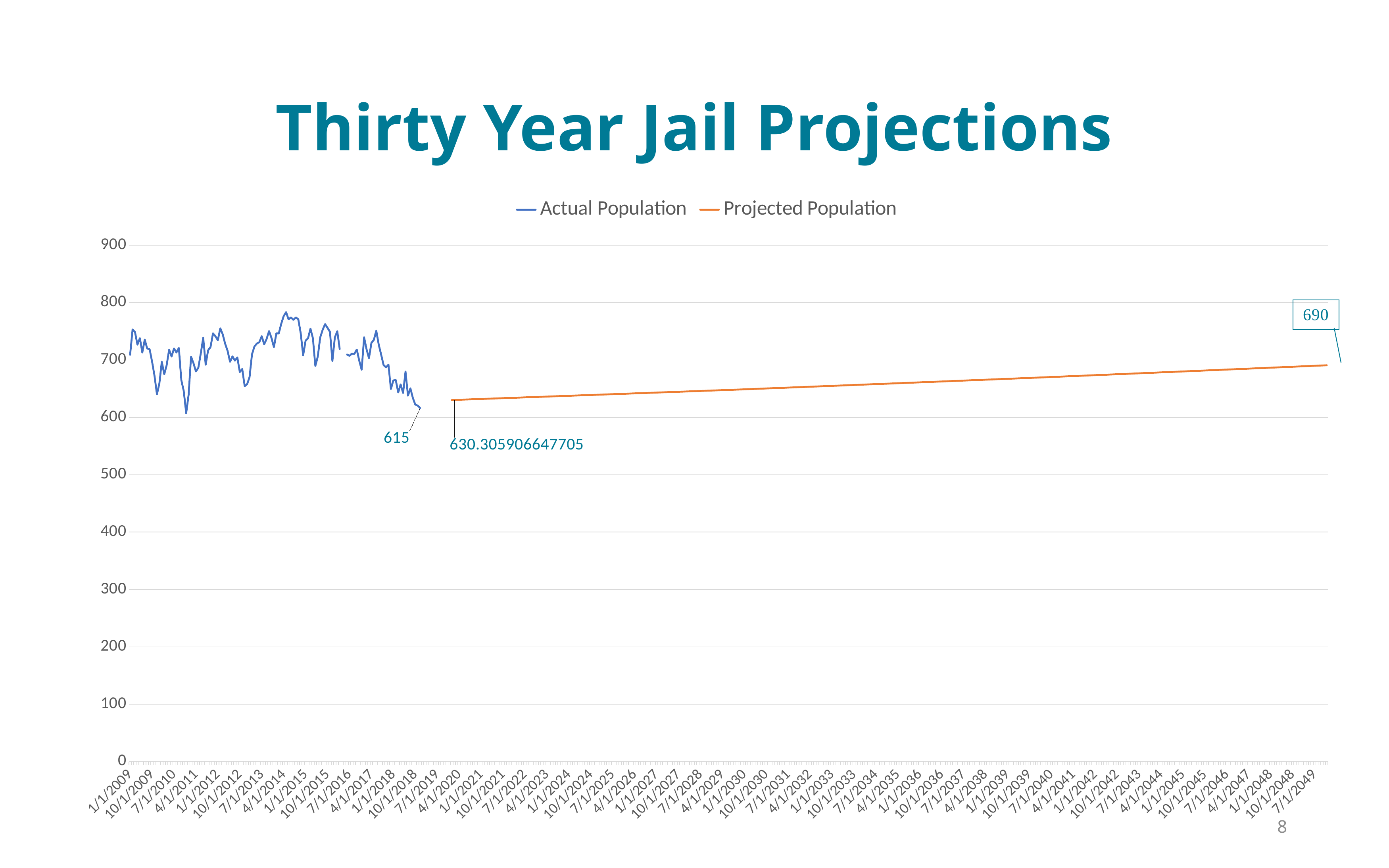
Does the Projected Population line rise or fall along the x axis? Rise Is the lowest value of the Actual Population line greater or less than 700? less What kind of chart is shown on the slide? Line chart Which series reaches the higher peak value, Actual Population or Projected Population? Actual Population What is the labelled value of the last Actual Population data point? 615 What is the labelled value at the start of the Projected Population line? 630.305906647705 Which is larger: the final Projected Population value or the last Actual Population value? The final Projected Population value (690) What is the difference between the final Projected Population value (690) and the last Actual Population value (615)? 75 What is the title of the chart? Thirty Year Jail Projections What is the labelled value at the end of the Projected Population line in 2049? 690 What colour is the Projected Population line? Orange How many series does the legend list? 2